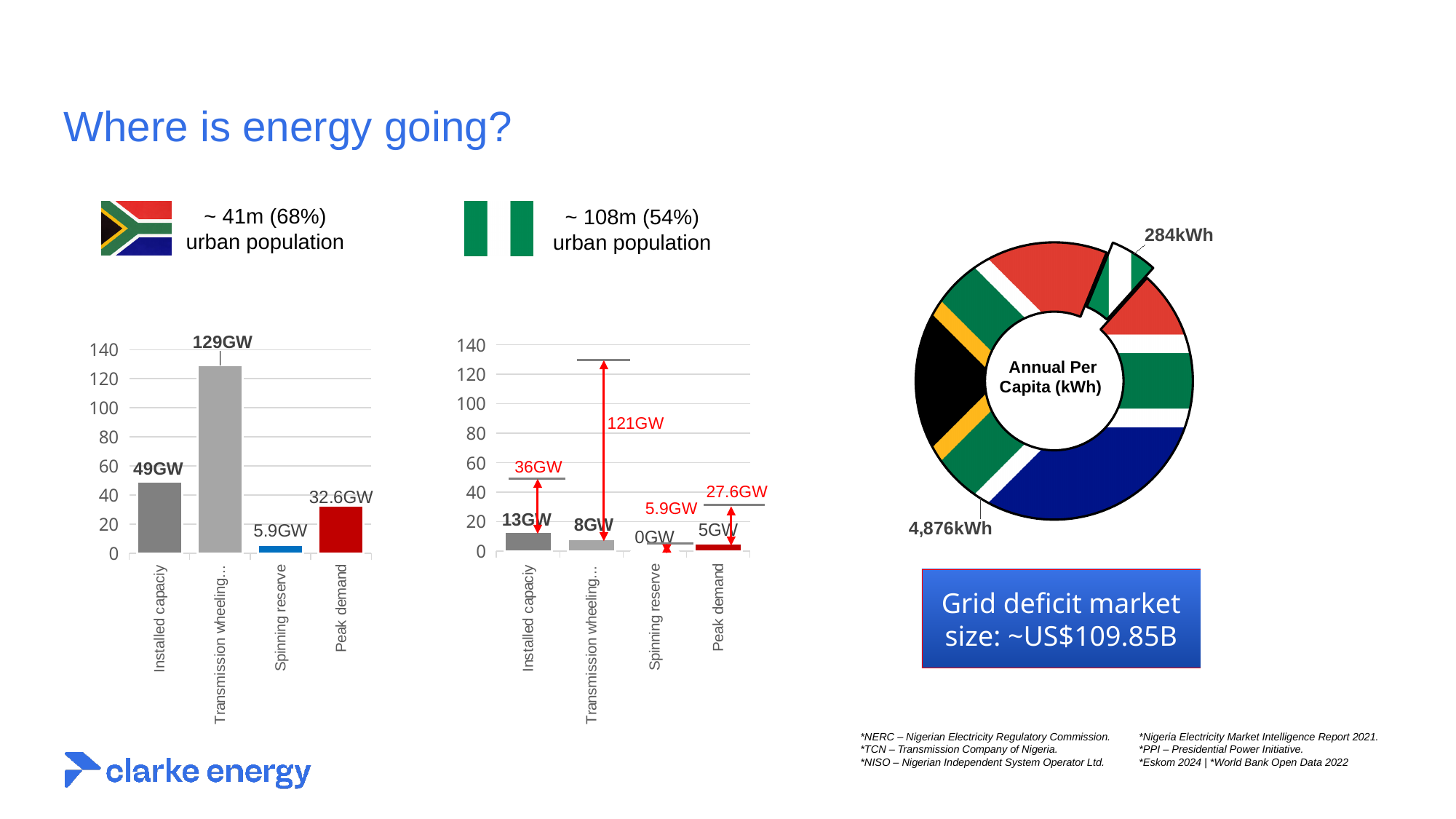
How many categories are shown on the x axis of the left bar chart? 4 In the middle bar chart (Nigeria), what is the value for Peak demand? 5GW In the middle bar chart (Nigeria), what is the gap labelled in red above the Transmission wheeling bar? 121GW In the left bar chart (South Africa), what is the value for Installed capacity? 49GW Which is larger: Peak demand in the left bar chart (South Africa) or Peak demand in the middle bar chart (Nigeria)? Left bar chart (South Africa) In the left bar chart (South Africa), which category has the highest value? Transmission wheeling In the left bar chart (South Africa), what is the value for Peak demand? 32.6GW In the middle bar chart (Nigeria), what is the value for Installed capacity? 13GW In the left bar chart (South Africa), which category has the lowest value? Spinning reserve In the middle bar chart (Nigeria), what is the value for Spinning reserve? 0GW What is the difference between Installed capacity in the left bar chart (49GW) and Installed capacity in the middle bar chart (13GW)? 36GW In the donut chart on the right (Annual Per Capita kWh), what is the value of the larger segment? 4,876kWh